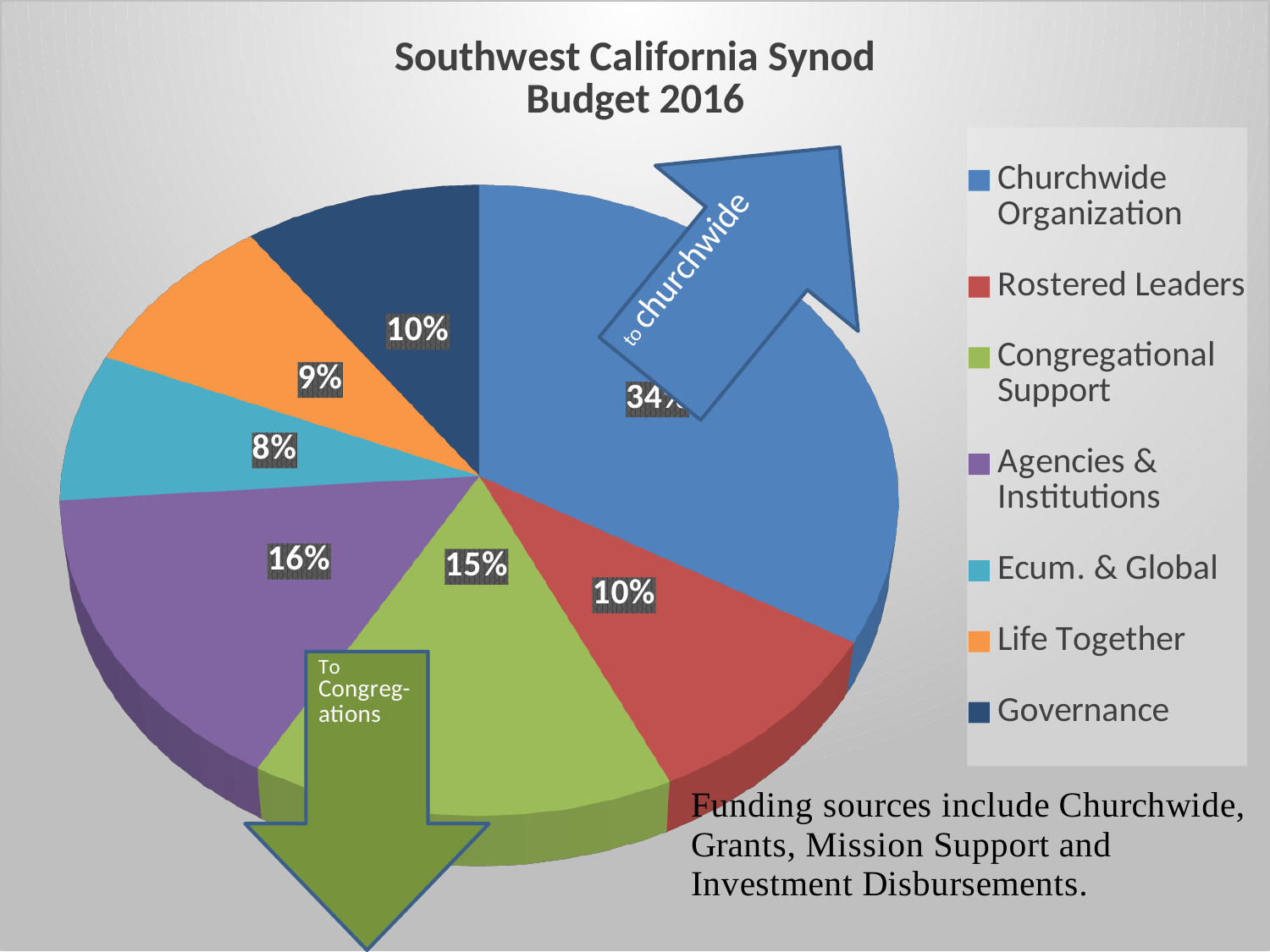
What percentage of the budget goes to Governance? 10% What percentage of the budget goes to Ecum. & Global? 8% Which category has the largest share of the budget? Churchwide Organization What is the difference in percentage points between Agencies & Institutions and Ecum. & Global? 8 What is the title of the chart? Southwest California Synod Budget 2016 Which is larger, the share for Congregational Support or the share for Rostered Leaders? Congregational Support What percentage of the budget goes to Agencies & Institutions? 16% What percentage of the budget goes to Congregational Support? 15% How many categories does the legend list? 7 Which category has the smallest share of the budget? Ecum. & Global What percentage of the budget goes to Life Together? 9% What type of chart is shown on the slide? pie chart